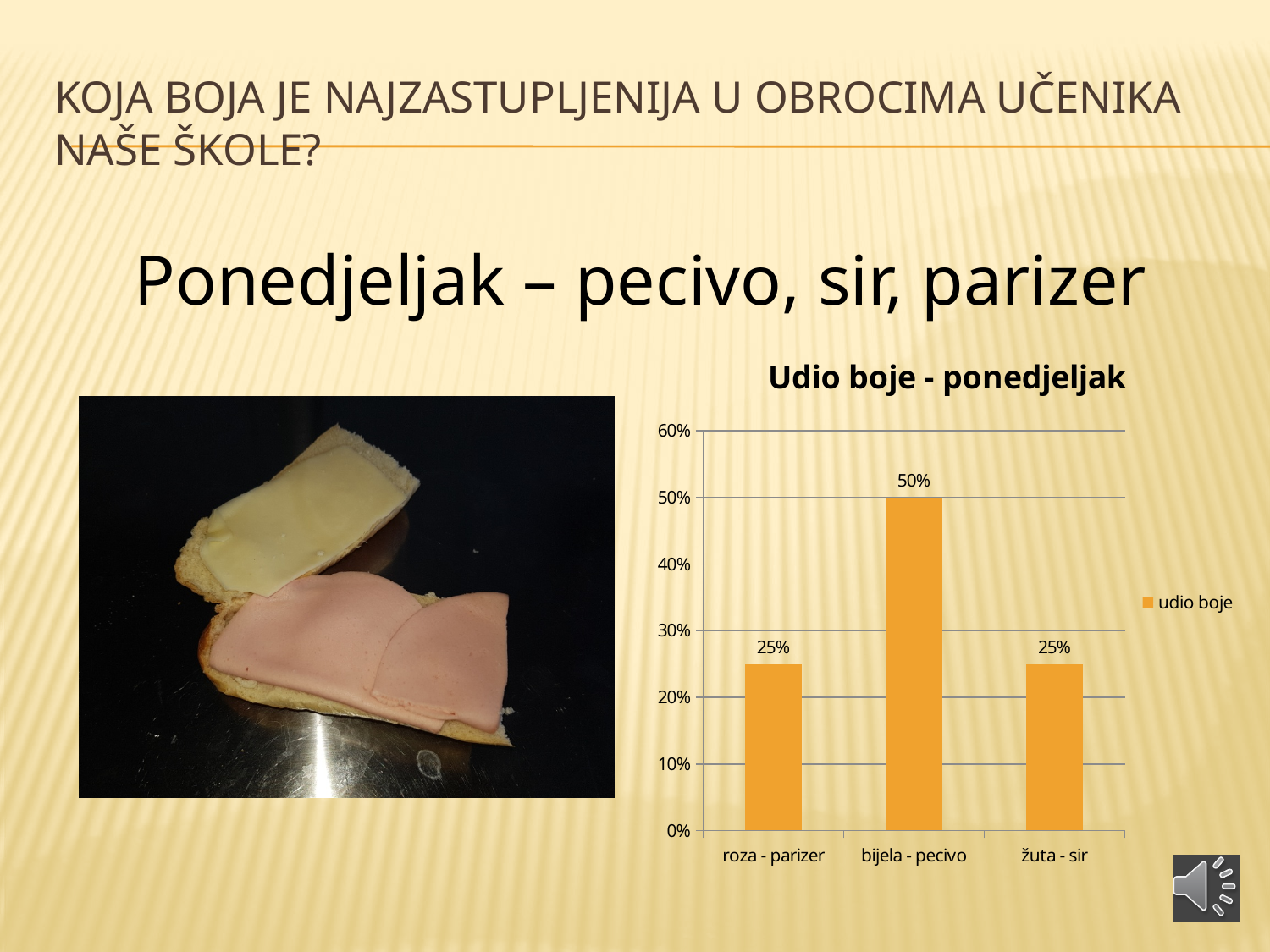
What is the title of the chart? Udio boje - ponedjeljak What is the difference between the values for bijela - pecivo and roza - parizer? 25% What is the value for bijela - pecivo in the chart? 50% Which category has the highest value in the chart? bijela - pecivo What is the value for roza - parizer in the chart? 25% What kind of chart is shown on the slide? bar chart Which is larger, the value for bijela - pecivo or the value for žuta - sir? bijela - pecivo What is the value for žuta - sir in the chart? 25% How many categories are shown on the x axis of the chart? 3 Is the value for bijela - pecivo greater or less than 40%? greater How many series does the chart legend list? 1 Is the value for roza - parizer greater or less than 30%? less